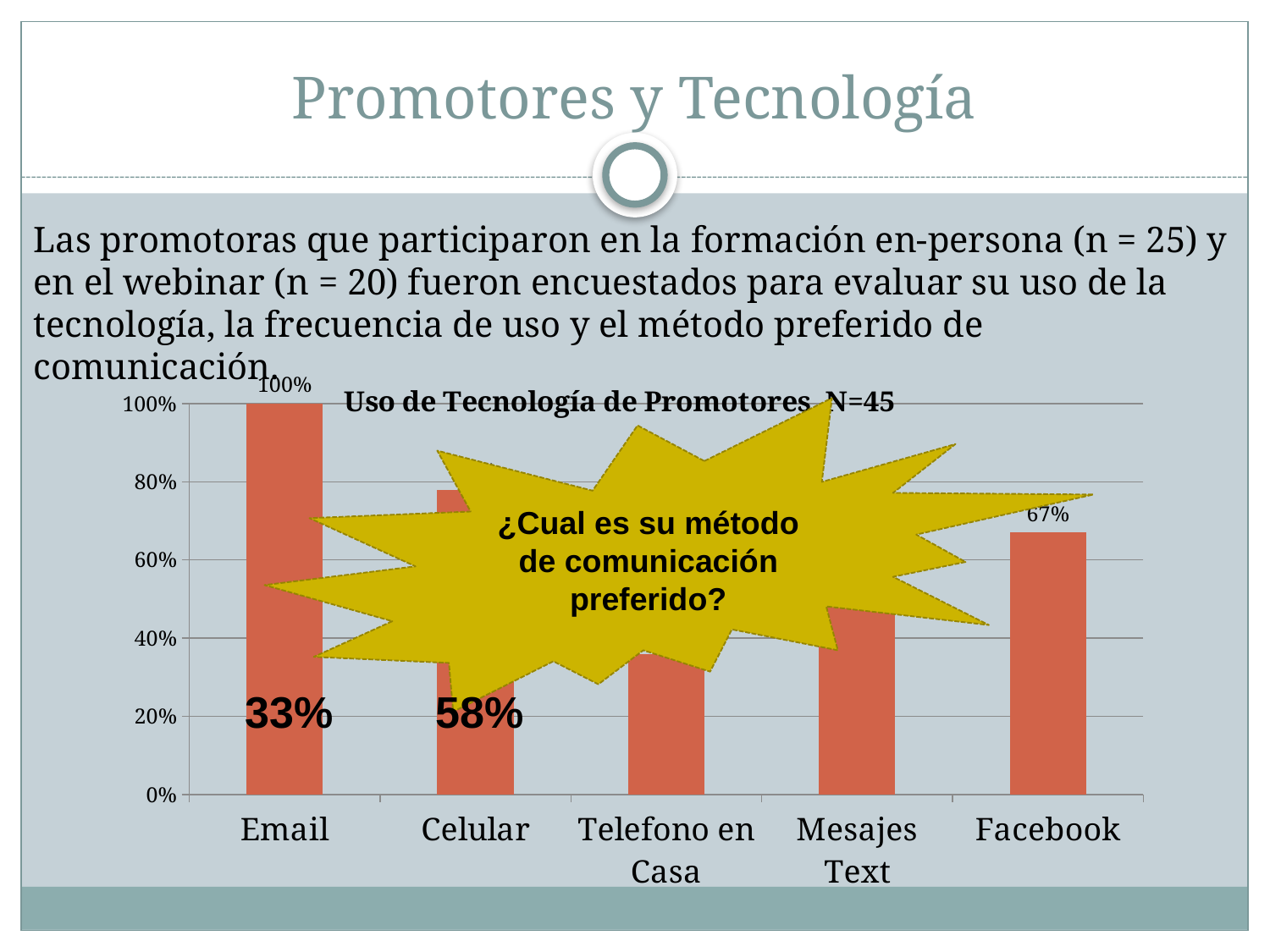
Which is larger, the value for Celular or the value for Facebook? Celular What kind of chart is shown on the slide? bar chart Which category has the highest value in the chart? Email What is the difference between the values for Email and Facebook? 33% Is the value for Celular greater or less than 60%? greater How many categories are shown on the x axis of the chart? 5 What is the value for Facebook in the chart? 67% Is the value for Mesajes Text greater or less than 40%? greater What is the value for Email in the chart? 100%